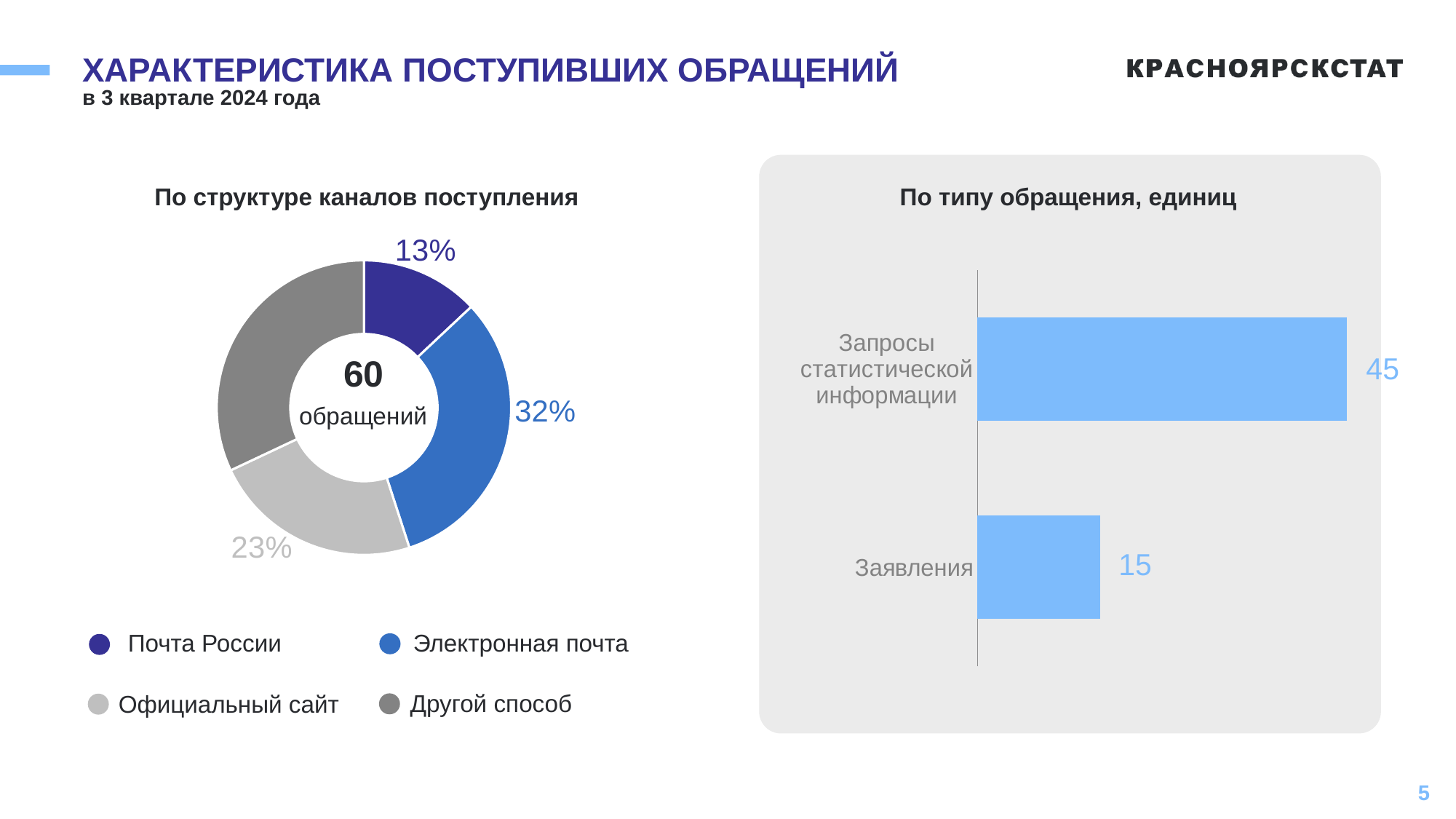
In the chart 'По типу обращения, единиц', what is the value for Заявления? 15 In the chart 'По типу обращения, единиц', what is the difference between the values for Запросы статистической информации and Заявления? 30 What kind of chart is 'По типу обращения, единиц'? Bar chart In the chart 'По структуре каналов поступления', which is larger: the share for Электронная почта or for Официальный сайт? Электронная почта In the chart 'По структуре каналов поступления', what share is shown for Почта России? 13% In the chart 'По структуре каналов поступления', what total number of обращений is shown in the centre of the donut? 60 In the chart 'По структуре каналов поступления', what share is shown for Электронная почта? 32% In the chart 'По типу обращения, единиц', what is the value for Запросы статистической информации? 45 In the chart 'По структуре каналов поступления', which channel has the smallest share? Почта России In the chart 'По структуре каналов поступления', what share is shown for Официальный сайт? 23% In the chart 'По типу обращения, единиц', which type of обращение has the highest value? Запросы статистической информации How many channels does the legend of the chart 'По структуре каналов поступления' list? 4